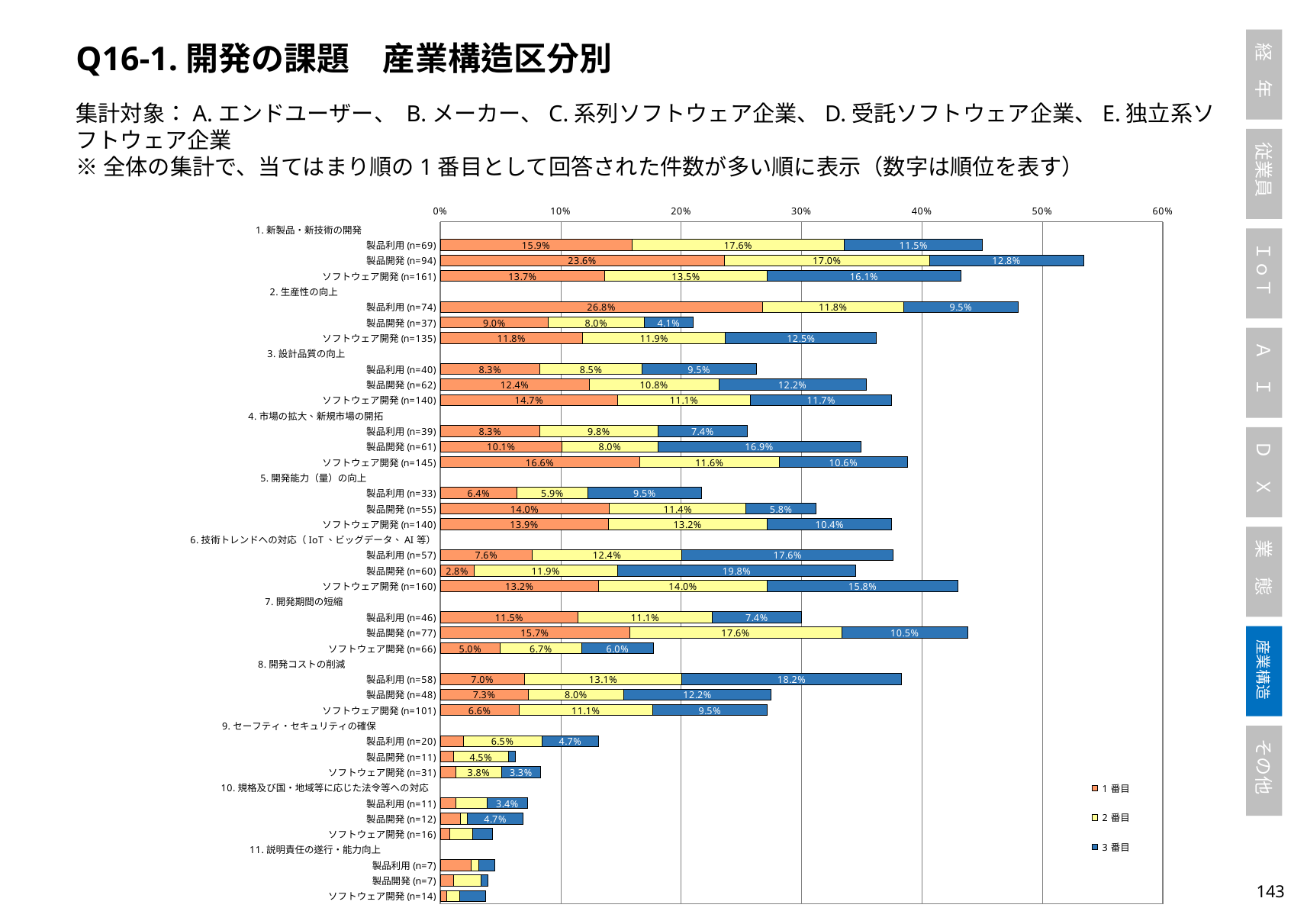
What is the 2番目 value for ソフトウェア開発 (n=160) under 6. 技術トレンドへの対応? 14.0% How many numbered issue groups are shown on the chart? 11 What kind of chart is shown on the slide? Stacked horizontal bar chart What is the total of the stacked bar for 製品利用 (n=74) under 2. 生産性の向上? 48.1% How many series does the legend list? 3 Is the total bar length for 製品利用 (n=20) under 9. セーフティ・セキュリティの確保 greater or less than 20%? less What is the 1番目 value for 製品開発 (n=94) under 1. 新製品・新技術の開発? 23.6% Which bar has the largest 1番目 segment in the chart? 製品利用 (n=74) under 2. 生産性の向上 Which has the larger 1番目 value under 2. 生産性の向上: 製品利用 (n=74) or 製品開発 (n=37)? 製品利用 (n=74) What is the 3番目 value for 製品開発 (n=60) under 6. 技術トレンドへの対応? 19.8% What is the difference between the 1番目 values for 製品開発 (n=94) and 製品利用 (n=69) under 1. 新製品・新技術の開発? 7.7 percentage points What is the total of the stacked bar for 製品開発 (n=37) under 2. 生産性の向上? 21.1%